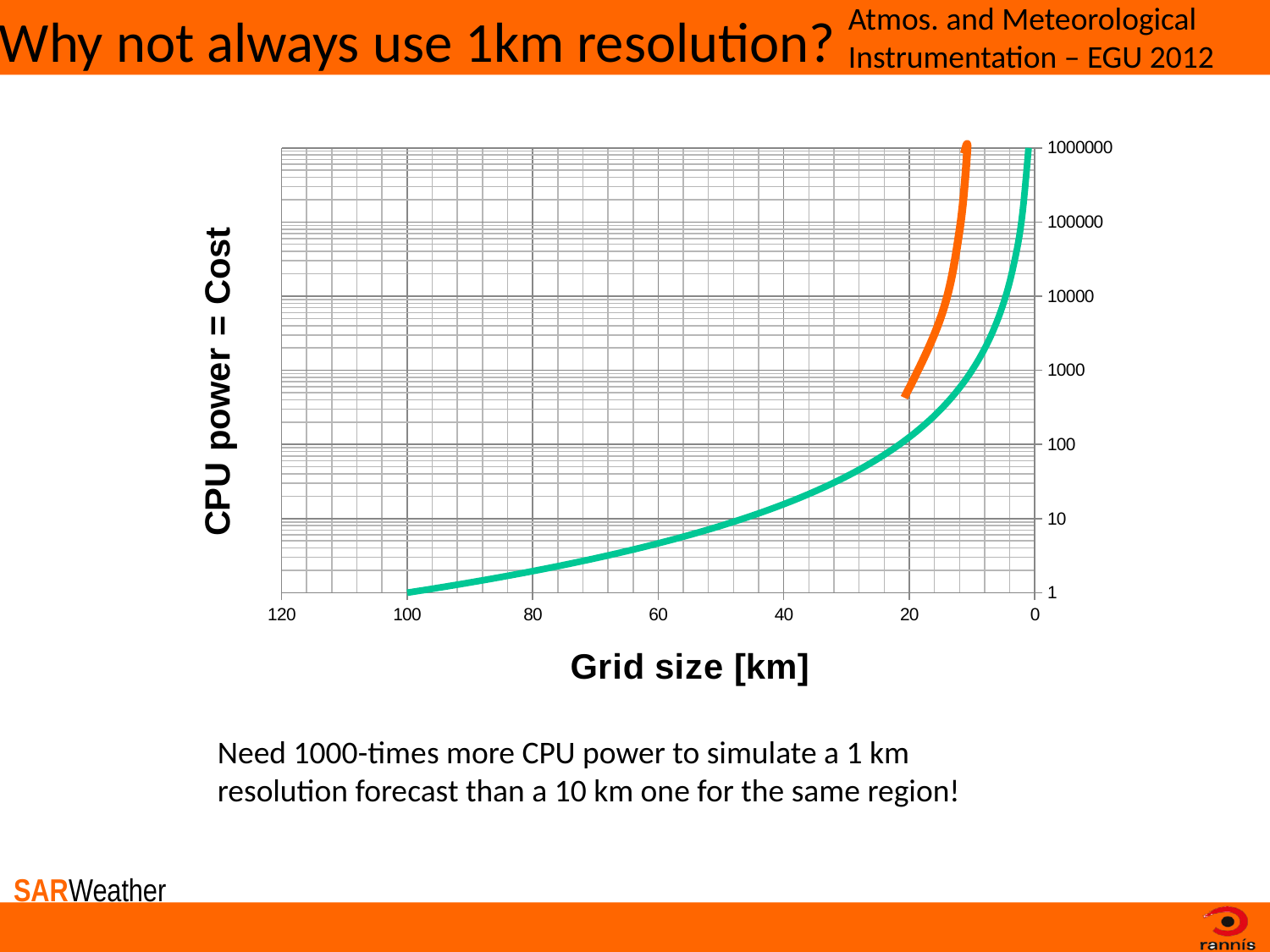
Is the value of the green curve at a grid size of 40 km greater or less than 10? greater What is the title of the y axis? CPU power = Cost Is the value of the green curve at a grid size of 40 km greater or less than 100? less How many tick labels are shown on the x axis? 7 What is the title of the x axis? Grid size [km] What kind of chart is shown on the slide? Line chart Is the value of the orange curve at a grid size of 20 km greater or less than 100? greater What is the value of the green curve at a grid size of 100 km? 1 How many curves (series) are plotted on the chart? 2 Does the CPU power rise or fall as the grid size decreases from 100 km toward 0 km? rises What is the highest value labelled on the y axis? 1000000